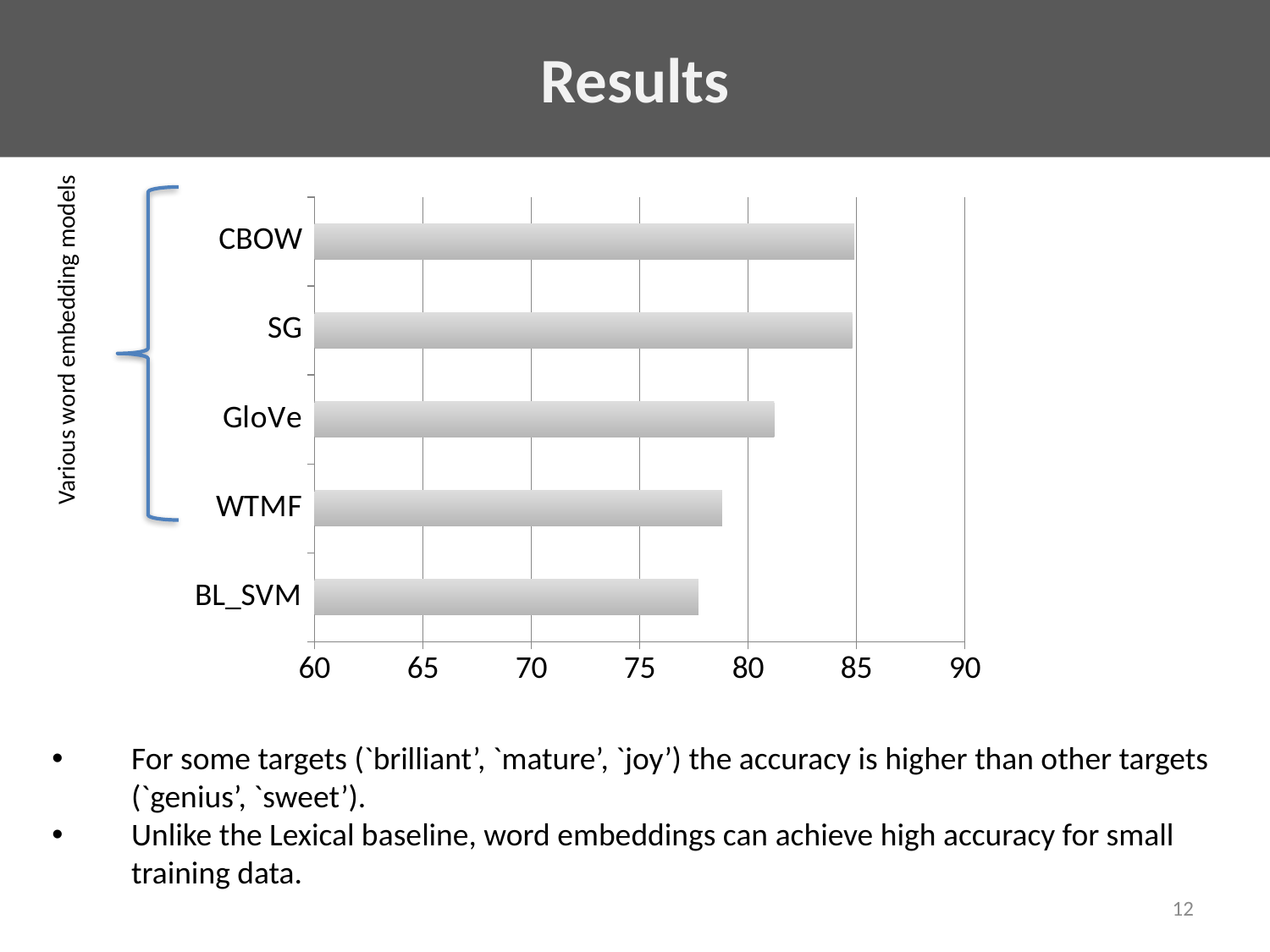
Which category has the lowest value in the chart? BL_SVM Is the value for SG greater or less than 80? greater Is the value for BL_SVM greater or less than 80? less What kind of chart is shown on the slide? bar chart Which category in the chart is not included in the bracket labelled 'Various word embedding models'? BL_SVM Is the value for WTMF greater or less than 75? greater How many categories (bars) does the chart show? 5 Which has the larger value, CBOW or GloVe? CBOW Which has the larger value, GloVe or WTMF? GloVe